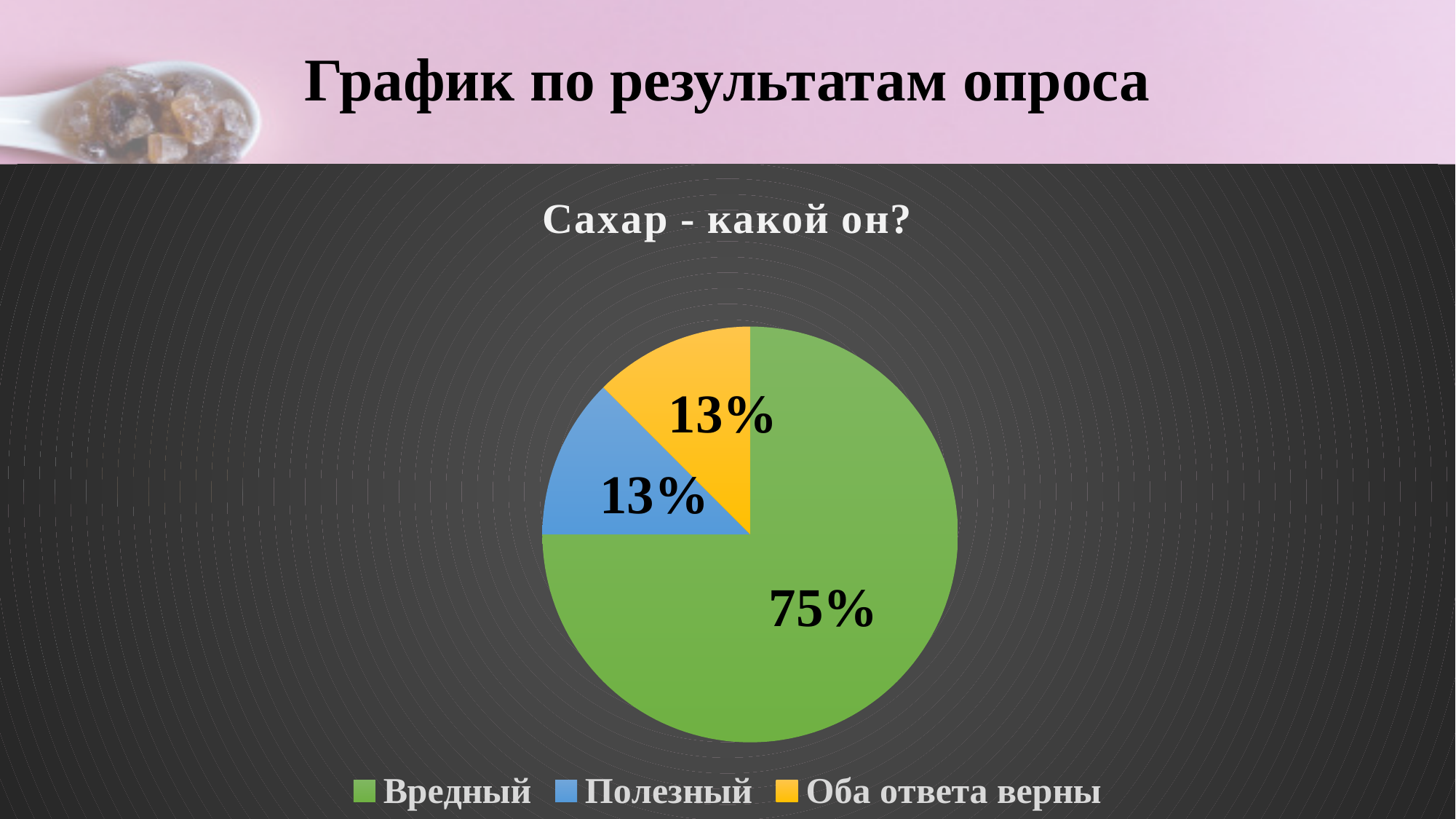
What share of the pie does Оба ответа верны have? 13% What is the difference between the share for Вредный and the share for Полезный? 62% What colour is the slice for Полезный? Blue How many entries does the legend list? 3 What is the title of the chart? Сахар - какой он? Which category has the largest slice of the pie? Вредный Which is larger, the slice for Вредный or the slice for Оба ответа верны? Вредный What kind of chart is shown on the slide? Pie chart What share of the pie does Полезный have? 13% What share of the pie does Вредный have? 75% How many slices does the pie chart have? 3